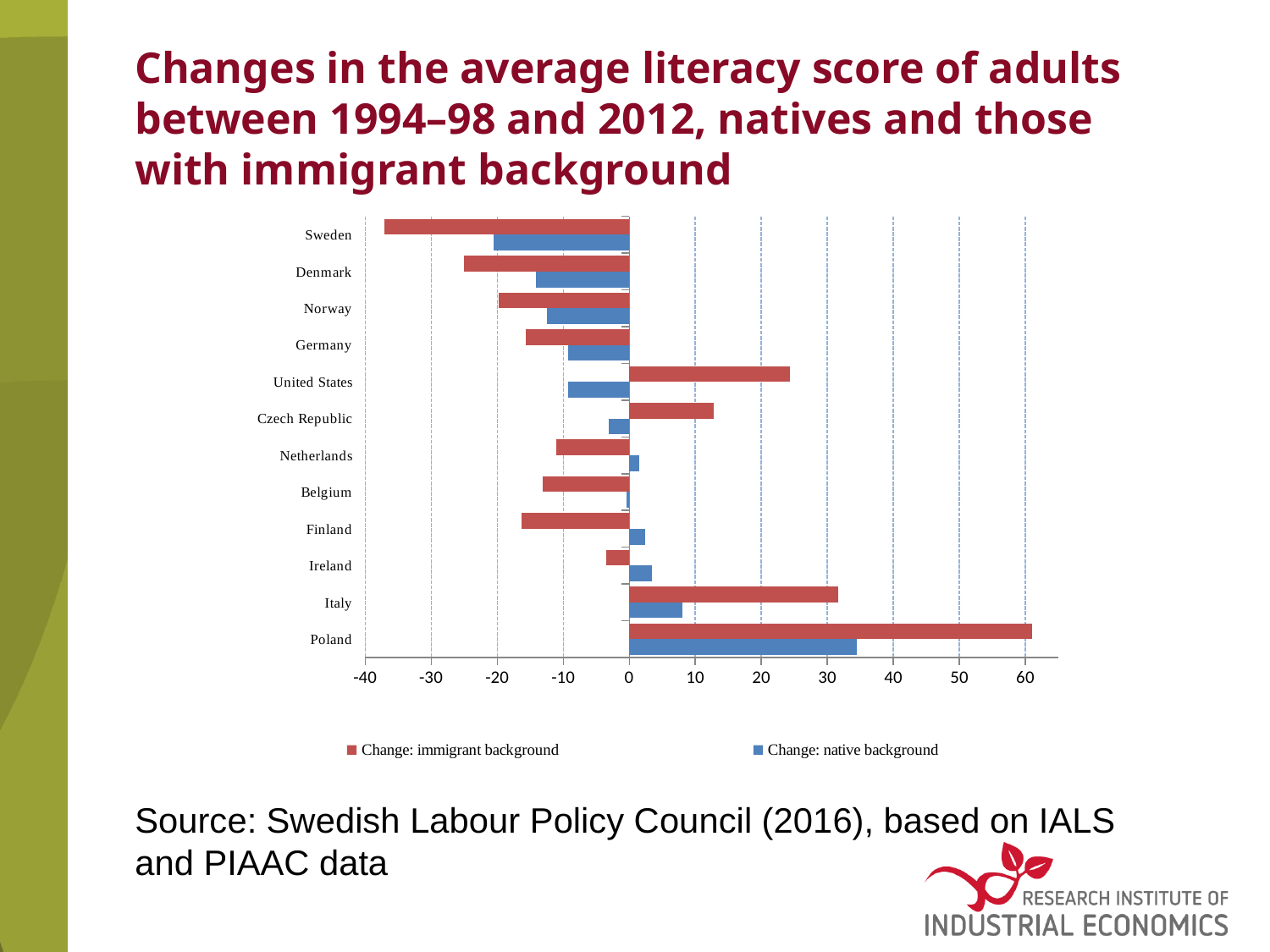
What are the two series named in the legend? Change: immigrant background; Change: native background Which country has the highest value for 'Change: native background'? Poland What kind of chart is shown on the slide? bar chart How many countries are listed on the chart? 12 Is the 'Change: immigrant background' value for Sweden greater or less than -30? less Which country has the lowest value for 'Change: native background'? Sweden Is the 'Change: immigrant background' value for Poland greater or less than 50? greater Which country has the lowest value for 'Change: immigrant background'? Sweden How many series does the legend list? 2 Which country has the highest value for 'Change: immigrant background'? Poland For the United States, which is larger: the change for immigrant background or the change for native background? Change: immigrant background Is the 'Change: immigrant background' value for Italy greater or less than 20? greater